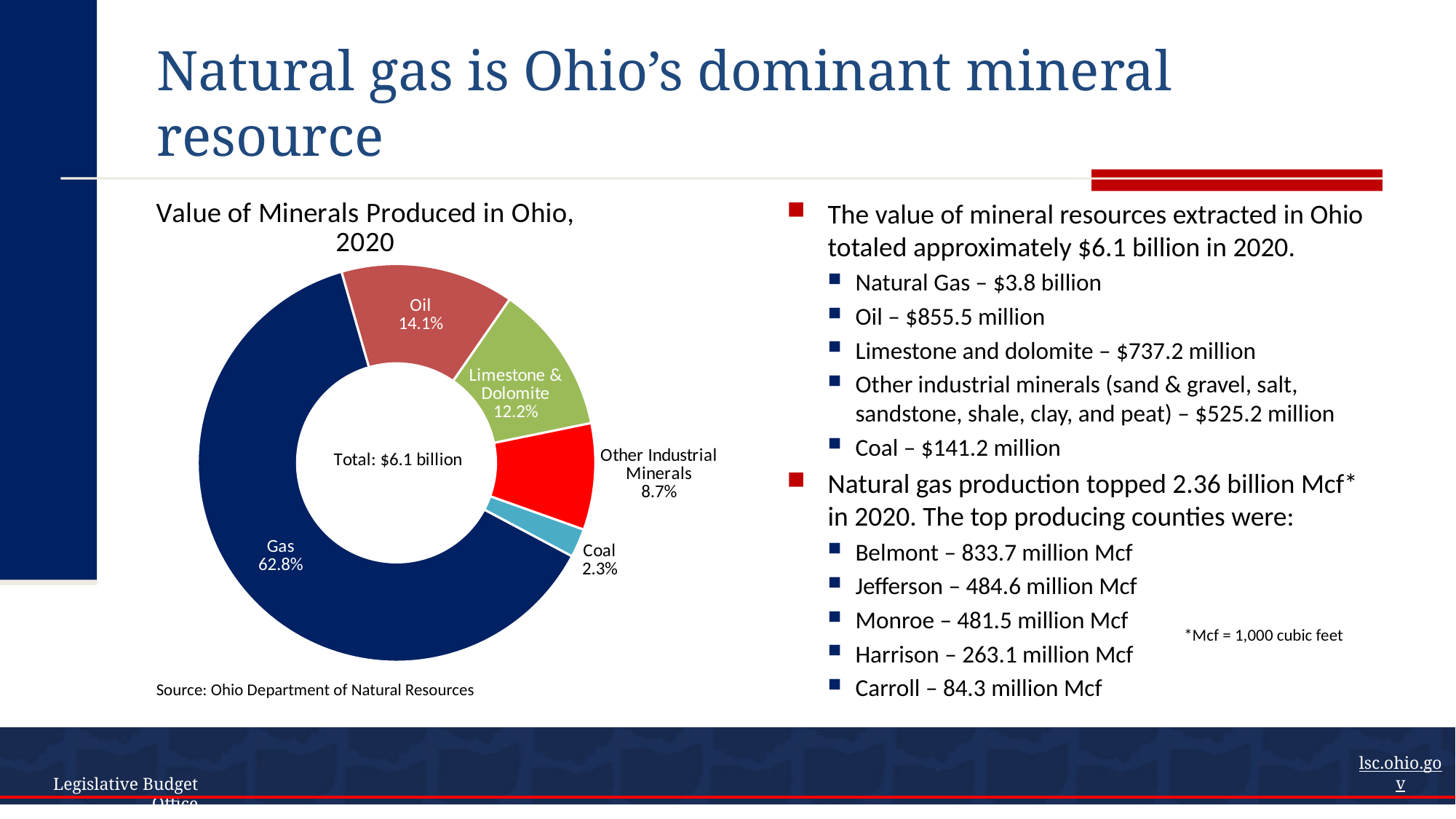
What is the share shown for Limestone & Dolomite? 12.2% How many categories are shown in the chart? 5 Which has a larger share, Other Industrial Minerals or Coal? Other Industrial Minerals What percentage of the pie is labelled for Oil? 14.1% What is the difference in percentage points between the Oil share and the Limestone & Dolomite share? 1.9 What share of the chart does Coal represent? 2.3% Which category has the largest share of the chart? Gas What share of the value of minerals produced in Ohio in 2020 does Gas account for? 62.8% What percentage is shown for Other Industrial Minerals? 8.7% Which category has the smallest share of the chart? Coal What kind of chart is shown on the slide? Pie chart (doughnut) What total value is printed in the centre of the chart? Total: $6.1 billion